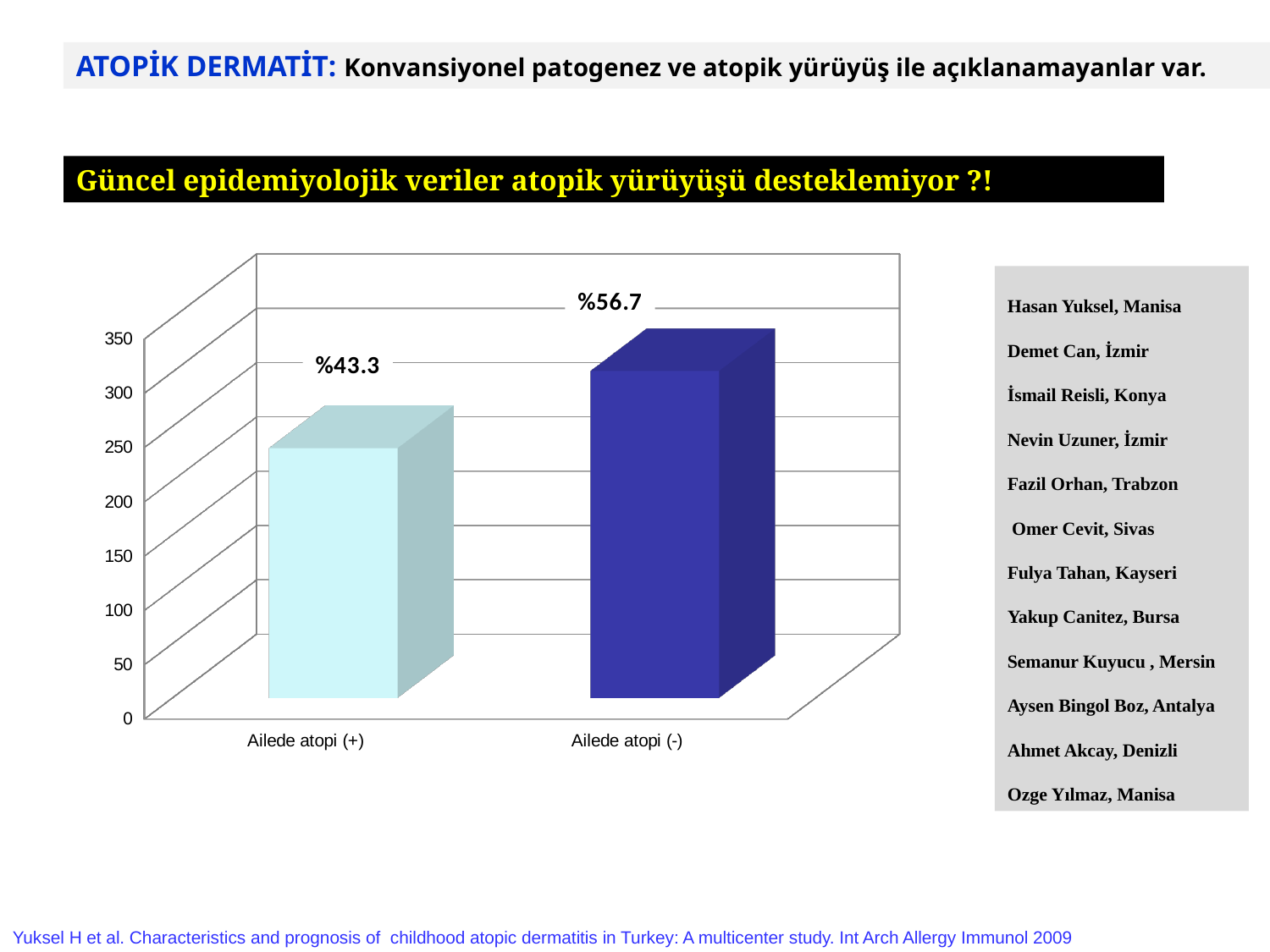
What colour is the bar for Ailede atopi (-)? dark blue Which category has the lower bar? Ailede atopi (+) Which category has the higher bar? Ailede atopi (-) Is the bar for Ailede atopi (-) greater or less than 200 on the vertical axis? greater Is the labelled value for Ailede atopi (+) larger or smaller than that for Ailede atopi (-)? smaller What is the difference between the labelled values for Ailede atopi (-) and Ailede atopi (+)? %13.4 What value is labelled on the bar for Ailede atopi (+)? %43.3 How many categories are shown on the x axis of the chart? 2 What value is labelled on the bar for Ailede atopi (-)? %56.7 What is the highest tick value shown on the vertical axis? 350 What kind of chart is shown on the slide? bar chart Is the bar for Ailede atopi (+) greater or less than 150 on the vertical axis? greater